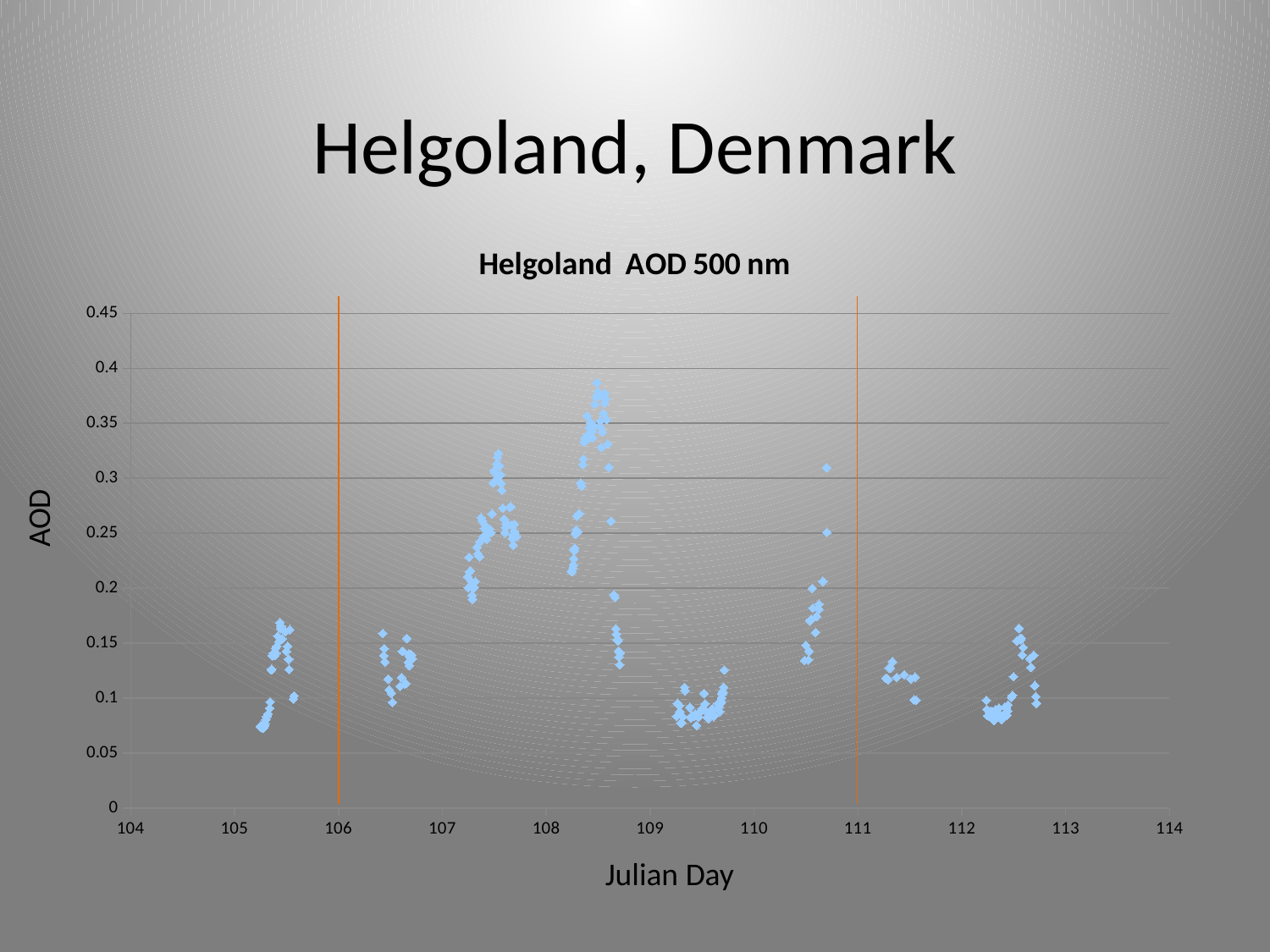
Between which two Julian Day ticks does the highest AOD value occur? 108 and 109 Is the highest AOD value plotted greater or less than 0.35? greater What label is shown on the vertical axis of the chart? AOD What is the highest tick value shown on the AOD axis? 0.45 Is the highest AOD value plotted greater or less than 0.4? less What is the range of the Julian Day axis, from its first tick to its last? 104 to 114 What is the title of the chart? Helgoland AOD 500 nm Are the AOD values plotted between Julian Day 109 and 110 greater or less than 0.15? less Which group of points has higher AOD values: those between Julian Day 108 and 109, or those between Julian Day 109 and 110? Between 108 and 109 What kind of chart is shown on the slide? Scatter chart